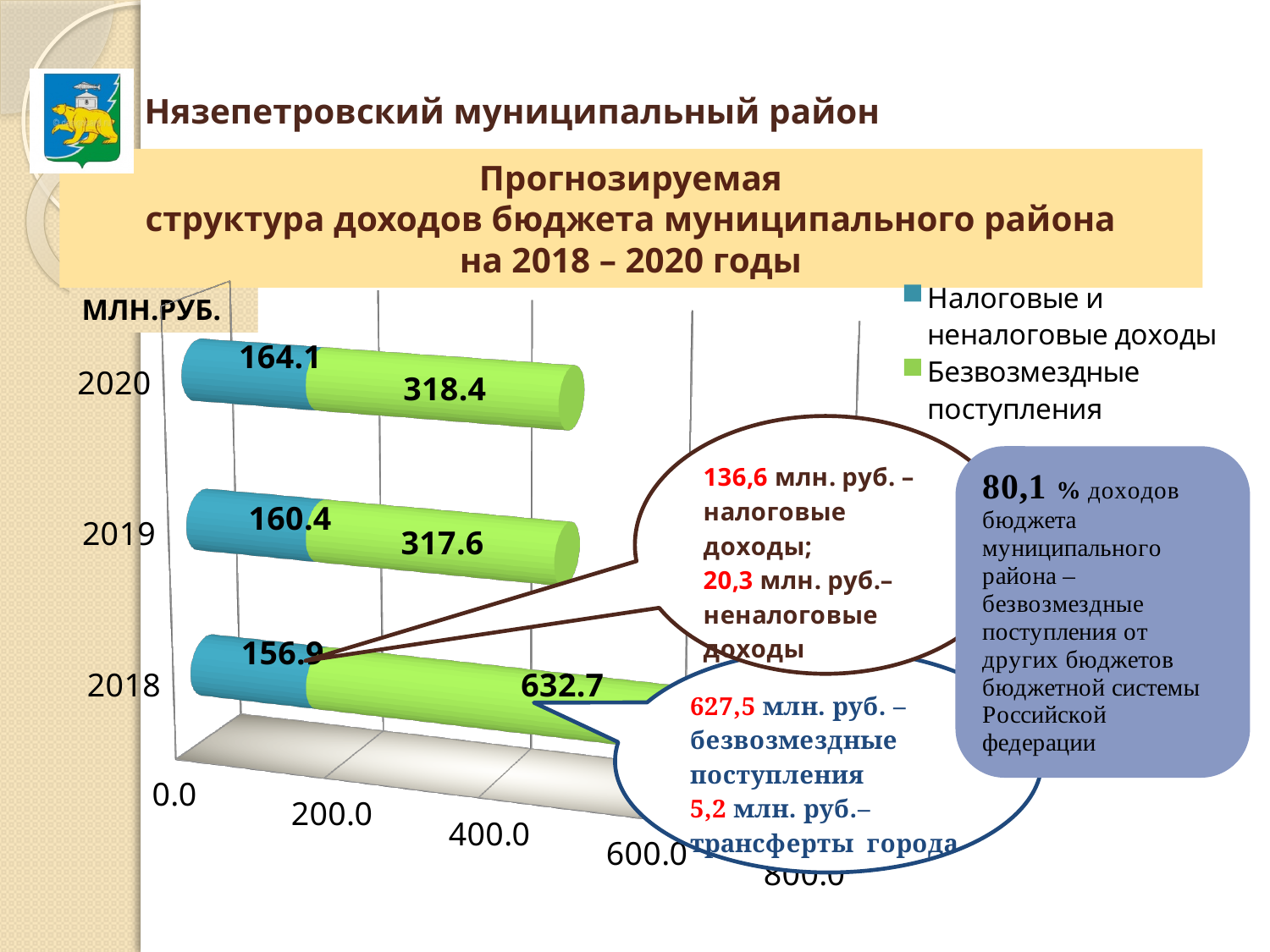
What kind of chart is shown on the slide? Stacked bar chart What is the value of Безвозмездные поступления for 2019? 317.6 Which is larger: Налоговые и неналоговые доходы in 2020 or in 2019? 2020 What is the value of Налоговые и неналоговые доходы for 2020? 164.1 What is the value of Безвозмездные поступления for 2018? 632.7 In which year is Безвозмездные поступления the highest? 2018 How many years are shown on the chart? 3 What is the total of the stacked bar for 2018? 789.6 What is the value of Налоговые и неналоговые доходы for 2018? 156.9 How many series does the legend list? 2 In which year is Налоговые и неналоговые доходы the lowest? 2018 What is the difference between Безвозмездные поступления in 2018 and in 2020? 314.3